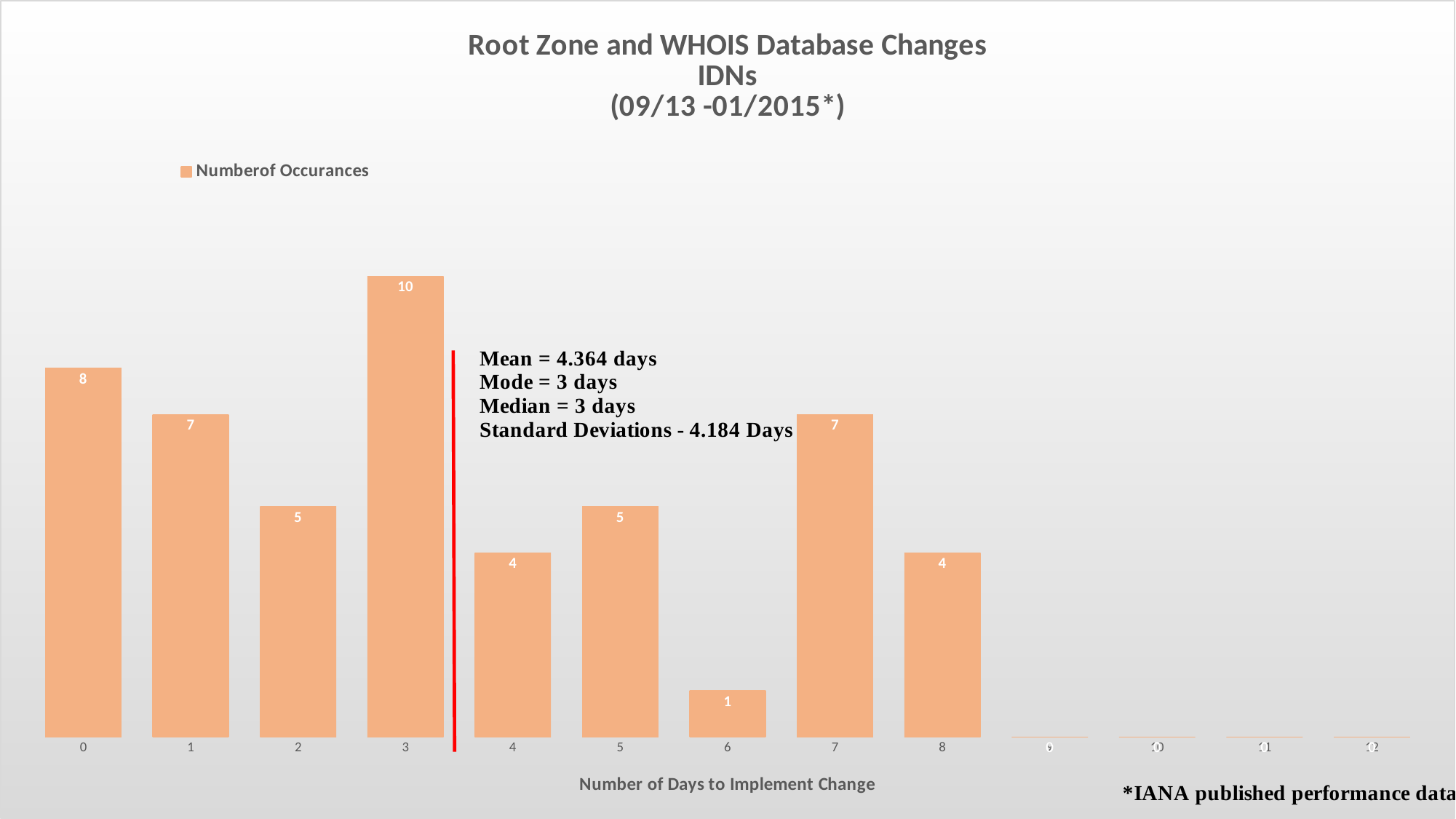
What is the number of occurrences for 6 days to implement change? 1 What is the difference between the number of occurrences for 3 days and for 0 days? 2 What is the number of occurrences for 0 days to implement change? 8 Which has more occurrences: 5 days or 4 days to implement change? 5 days What type of chart is shown on the slide? bar chart Which has more occurrences: 0 days or 1 day to implement change? 0 days What is the number of occurrences for 8 days to implement change? 4 What series name does the legend show? Numberof Occurances What is the difference between the number of occurrences for 7 days and for 6 days? 6 What is the mean number of days stated on the chart? 4.364 days What is the number of occurrences for 3 days to implement change? 10 Which number of days to implement change has the highest number of occurrences? 3